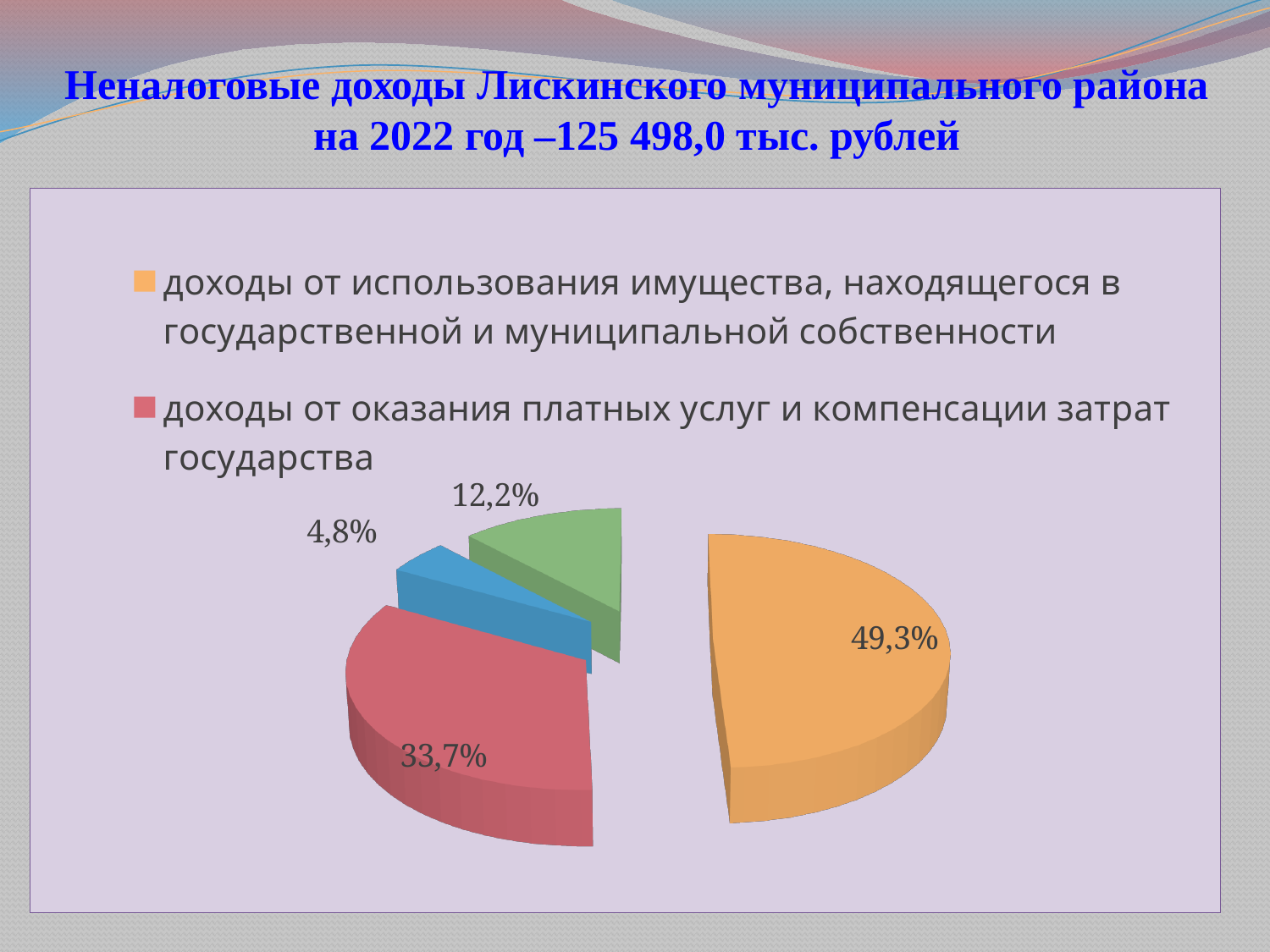
What share of the pie is labelled for доходы от использования имущества, находящегося в государственной и муниципальной собственности? 49,3% What share of the pie is labelled for доходы от оказания платных услуг и компенсации затрат государства? 33,7% By how many percentage points does the slice for доходы от использования имущества exceed the slice for доходы от оказания платных услуг и компенсации затрат государства? 15,6 What is the smallest percentage labelled on the pie chart? 4,8% What is the largest percentage labelled on the pie chart? 49,3% What kind of chart is shown on the slide? Pie chart How many entries does the legend list? 2 Which is larger: the slice for доходы от оказания платных услуг и компенсации затрат государства or the slice for доходы от использования имущества, находящегося в государственной и муниципальной собственности? доходы от использования имущества, находящегося в государственной и муниципальной собственности Which category has the largest slice of the pie? доходы от использования имущества, находящегося в государственной и муниципальной собственности What colour is the slice labelled 12,2%? Green How many slices does the pie chart have? 4 What total amount of non-tax revenue for 2022 is stated in the slide title? 125 498,0 тыс. рублей